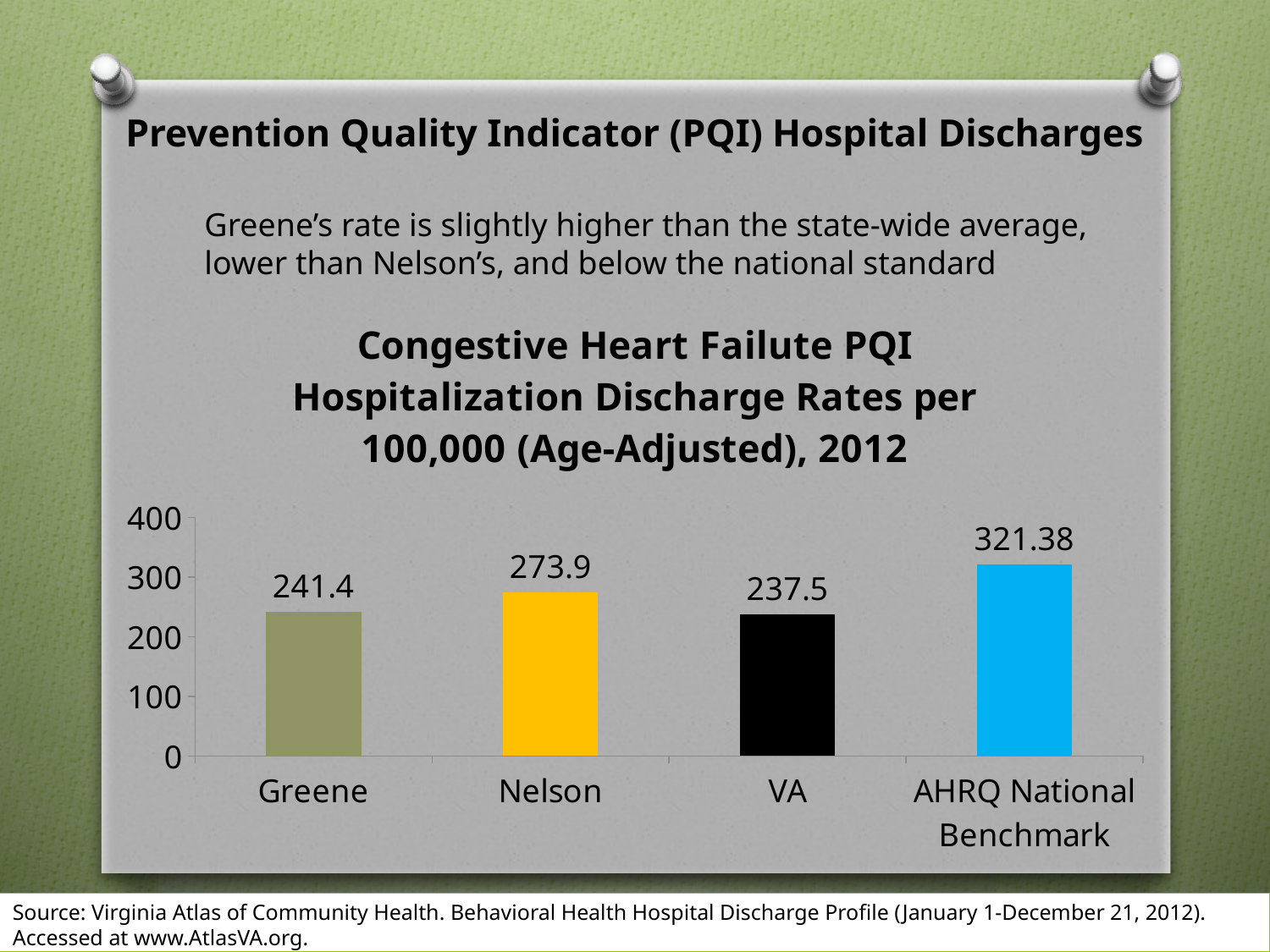
What is the difference between the Nelson value and the Greene value? 32.5 What is the value shown for Nelson? 273.9 Which is larger, the value for Greene or the value for VA? Greene Which category has the highest value? AHRQ National Benchmark What is the Congestive Heart Failure PQI hospitalization discharge rate for Greene? 241.4 What is the value shown for VA? 237.5 Which category has the lowest value? VA What is the value shown for the AHRQ National Benchmark? 321.38 What colour is the bar for Nelson? Yellow Is the value for the AHRQ National Benchmark greater or less than 300? greater What kind of chart is shown on the slide? Bar chart How many categories are shown on the chart? 4